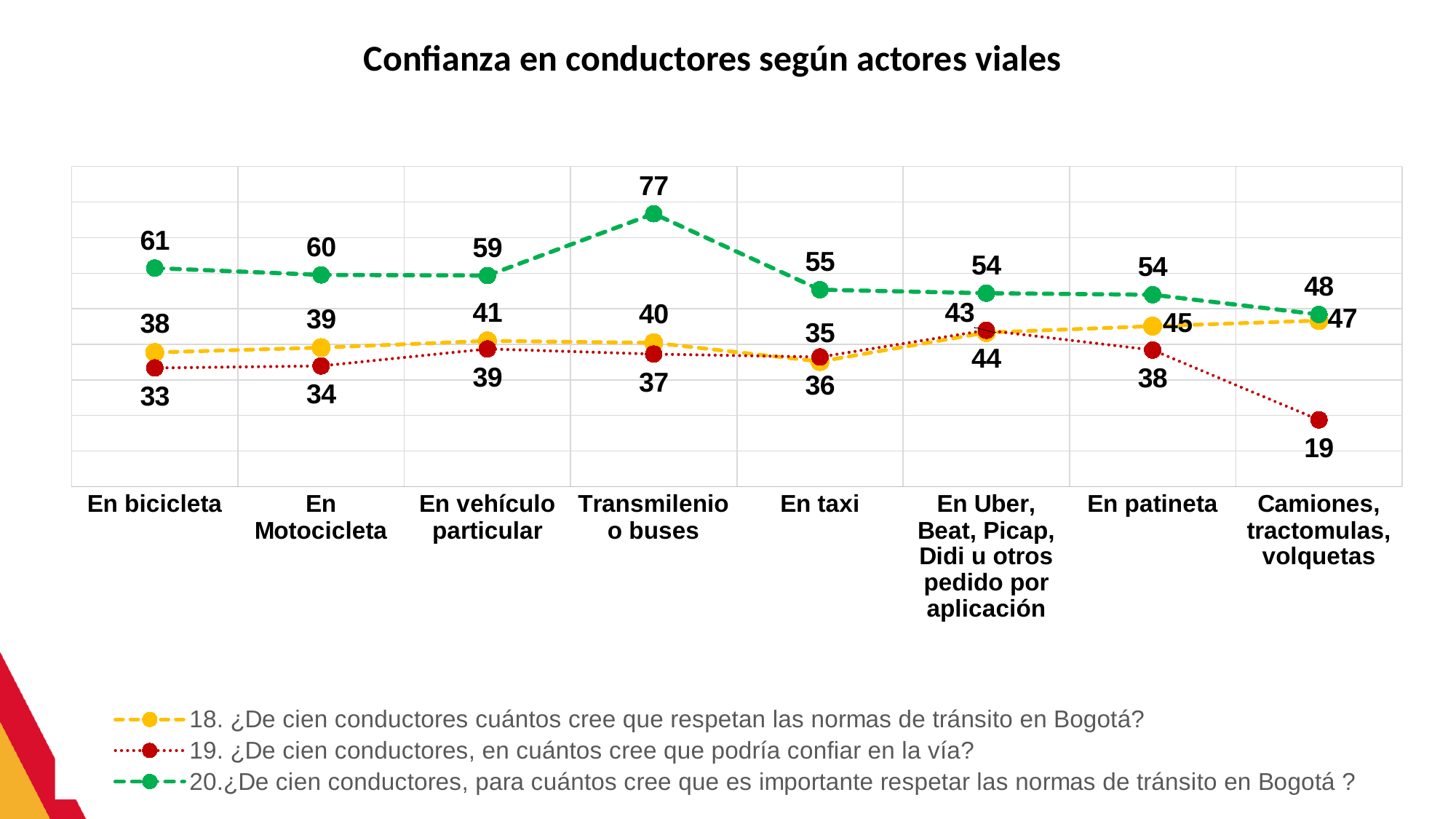
For which category is series 20 (green) highest? Transmilenio o buses What kind of chart is shown on the slide? line chart What is the value of series 20 (green) for Transmilenio o buses? 77 For which category is series 19 (red) lowest? Camiones, tractomulas, volquetas For En patineta, which is larger: series 18 (yellow) or series 19 (red)? series 18 (yellow) How many series does the legend list? 3 What is the value of series 19 (red) for Camiones, tractomulas, volquetas? 19 What is the value of series 18 (yellow) for En bicicleta? 38 Does series 20 (green) rise or fall from En taxi to Camiones, tractomulas, volquetas? fall What is the difference between series 20 (green) and series 18 (yellow) for En bicicleta? 23 What is the title of the chart? Confianza en conductores según actores viales How many categories are shown on the x axis? 8